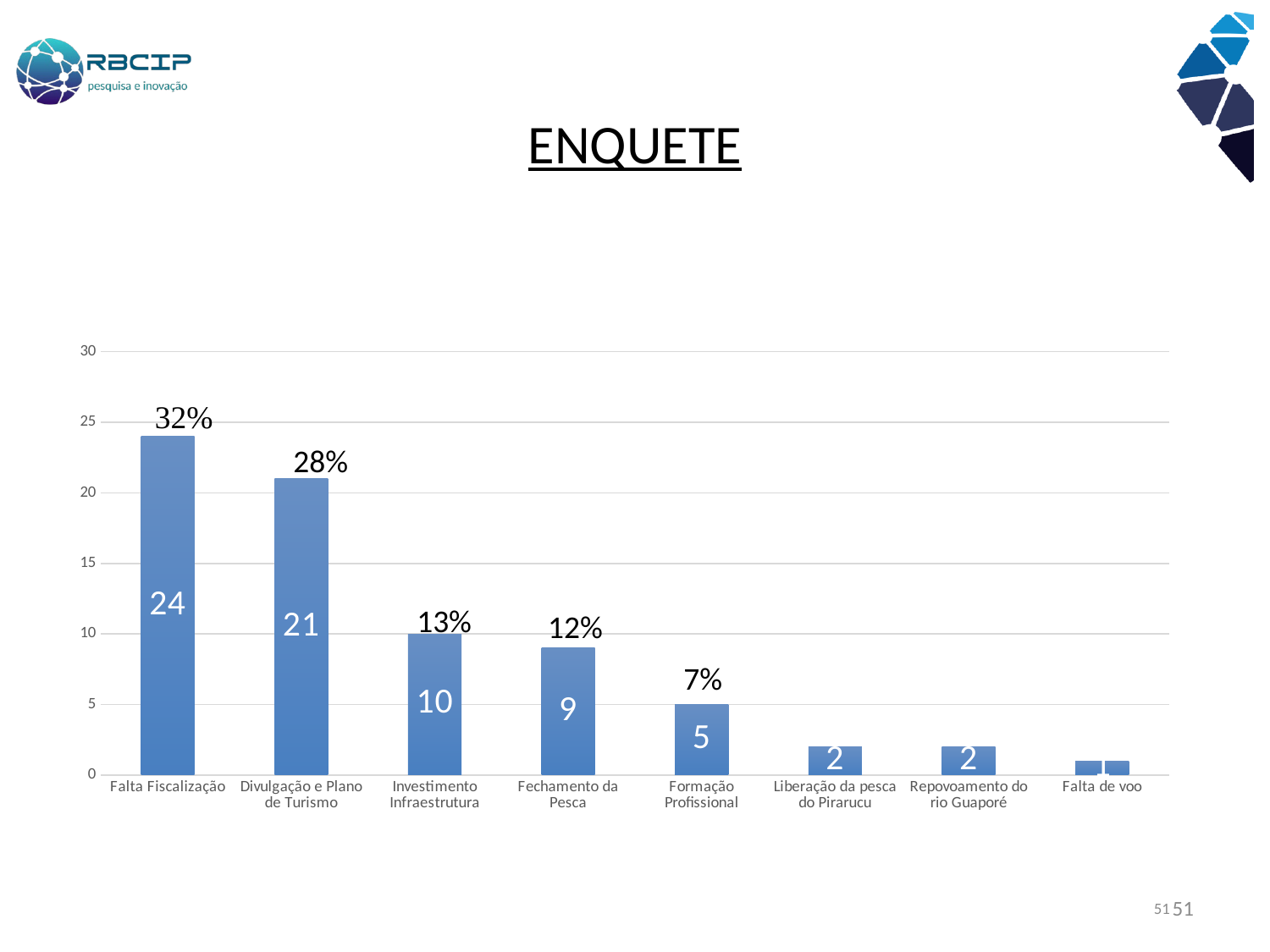
What is the difference between the values for Falta Fiscalização and Divulgação e Plano de Turismo? 3 What percentage is shown above the bar for Investimento Infraestrutura? 13% Which category has the highest value? Falta Fiscalização Is the value for Falta de voo greater or less than 5? less What is the value for Formação Profissional? 5 What is the value for Falta Fiscalização? 24 What is the difference between the values for Investimento Infraestrutura and Fechamento da Pesca? 1 How many categories are shown on the x axis? 8 What is the title of the slide containing the chart? ENQUETE Which is larger, the value for Fechamento da Pesca or the value for Formação Profissional? Fechamento da Pesca What kind of chart is shown on the slide? bar chart What is the value for Divulgação e Plano de Turismo? 21